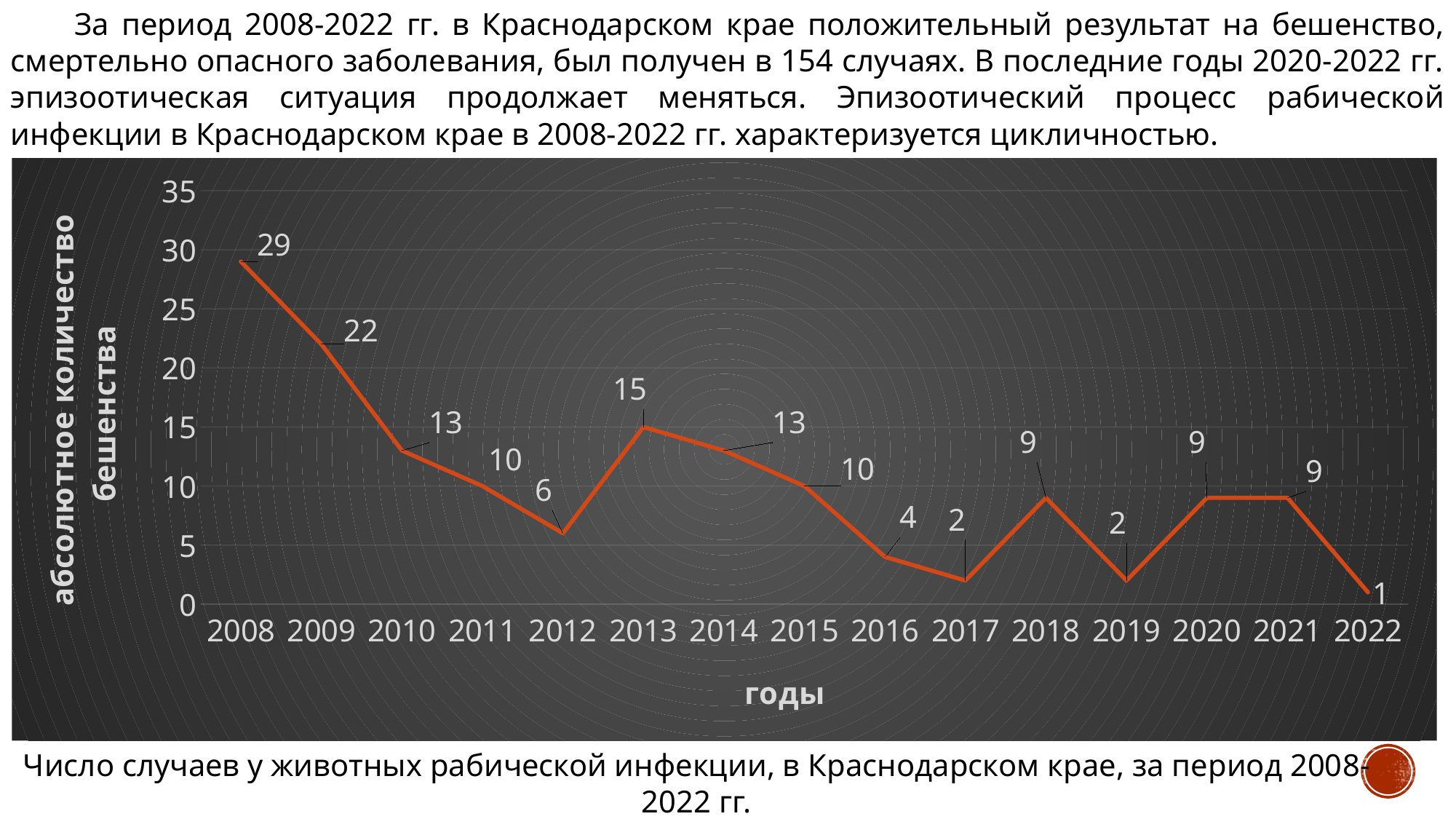
What is the value plotted for 2016? 4 What is the value plotted for 2022? 1 Which is larger, the value for 2014 or the value for 2015? 2014 What is the difference between the values for 2013 and 2012? 9 What type of chart is shown on the slide? line chart What is the number of rabies cases in 2008? 29 What is the difference between the values for 2008 and 2009? 7 What is the label of the x axis? годы Which year has the highest number of cases? 2008 What is the value plotted for 2013? 15 Which year has the lowest number of cases? 2022 How many years are plotted on the x axis? 15